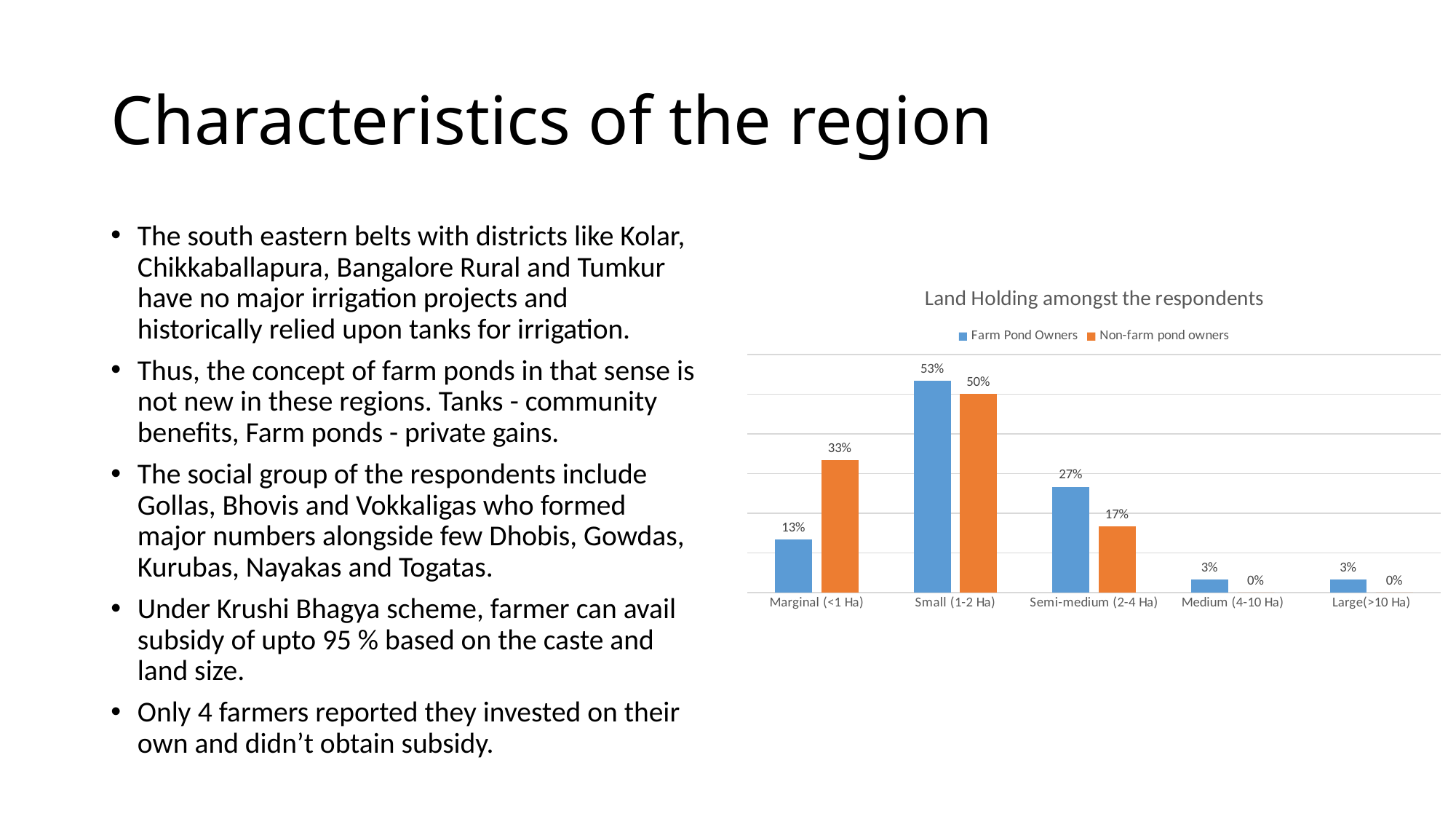
What is the value for Non-farm pond owners in the Marginal (<1 Ha) category? 33% Which category has the lowest value for Non-farm pond owners? Medium (4-10 Ha) and Large(>10 Ha) What is the value for Non-farm pond owners in the Semi-medium (2-4 Ha) category? 17% Which series is shown in orange? Non-farm pond owners What is the difference between Farm Pond Owners and Non-farm pond owners in the Marginal (<1 Ha) category? 20% What kind of chart is shown on the slide? Bar chart Which category has the highest value for Farm Pond Owners? Small (1-2 Ha) How many land holding categories are shown on the x axis? 5 What is the title of the chart? Land Holding amongst the respondents What is the value for Farm Pond Owners in the Small (1-2 Ha) category? 53% In the Semi-medium (2-4 Ha) category, which series has the larger value? Farm Pond Owners How many series does the legend list? 2